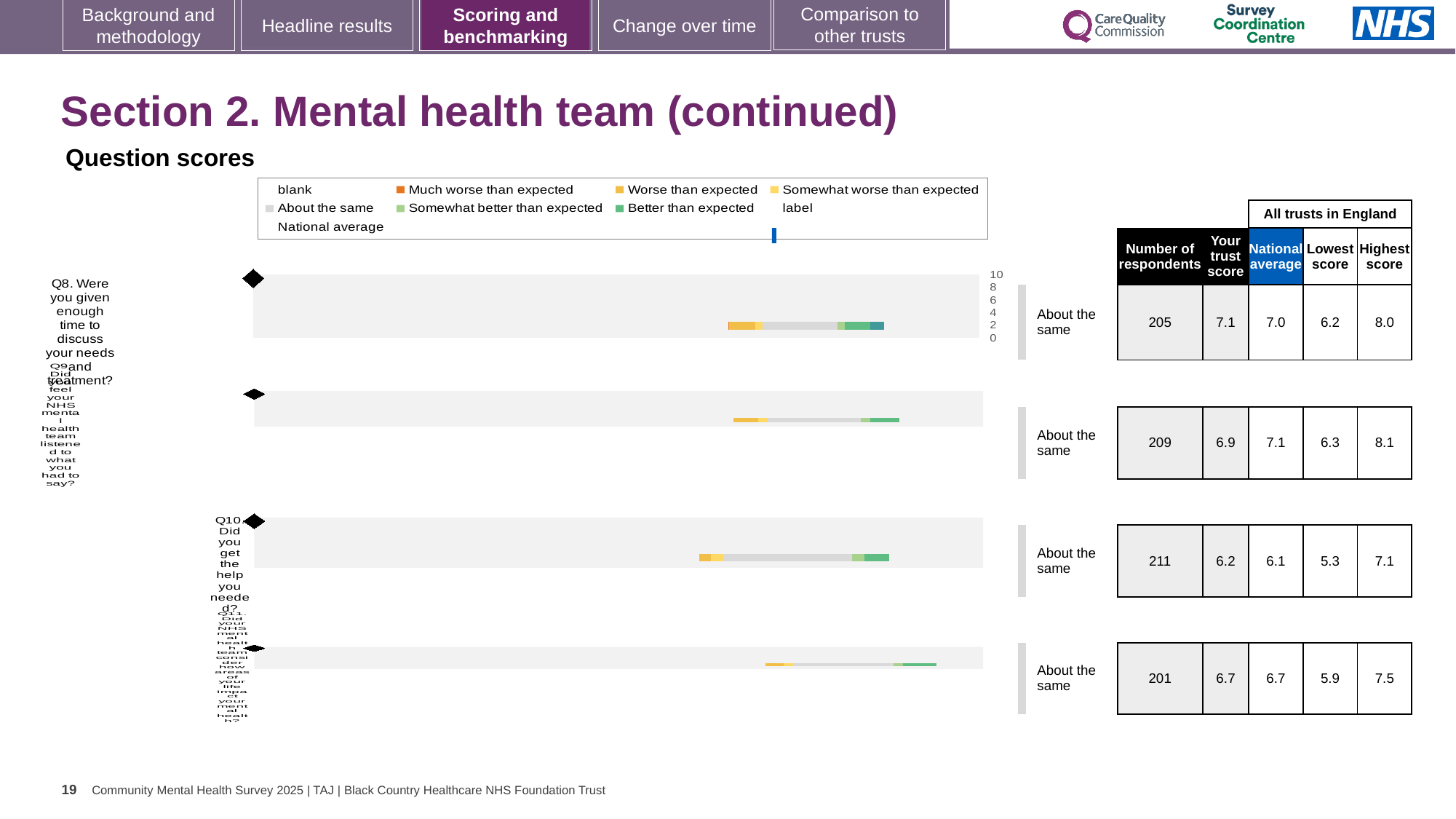
For the Q8 chart, what is the national average score? 7.0 What kind of chart is used to show the question scores on this slide? bar chart For the Q8 chart, what is the 'Your trust score' value? 7.1 How many question charts (Q8 to Q11) are shown on the slide? 4 For the Q10 chart (Did you get the help you needed?), what is the highest score among all trusts in England? 7.1 For the Q9 chart (Did you feel your NHS mental health team listened to what you had to say?), what is the lowest score among all trusts in England? 6.3 For the Q8 chart, which is larger: the trust score or the national average? the trust score (7.1) For the Q10 chart, what is the difference between the highest score and the lowest score among all trusts in England? 1.8 What benchmark category is shown next to the Q8 chart? About the same For the Q8 chart (Were you given enough time to discuss your needs and treatment?), what is the number of respondents shown in the table? 205 For the Q11 chart (the bottom chart), what is the 'Your trust score' value? 6.7 Which of the four questions (Q8 to Q11) has the highest number of respondents? Q10 (211)